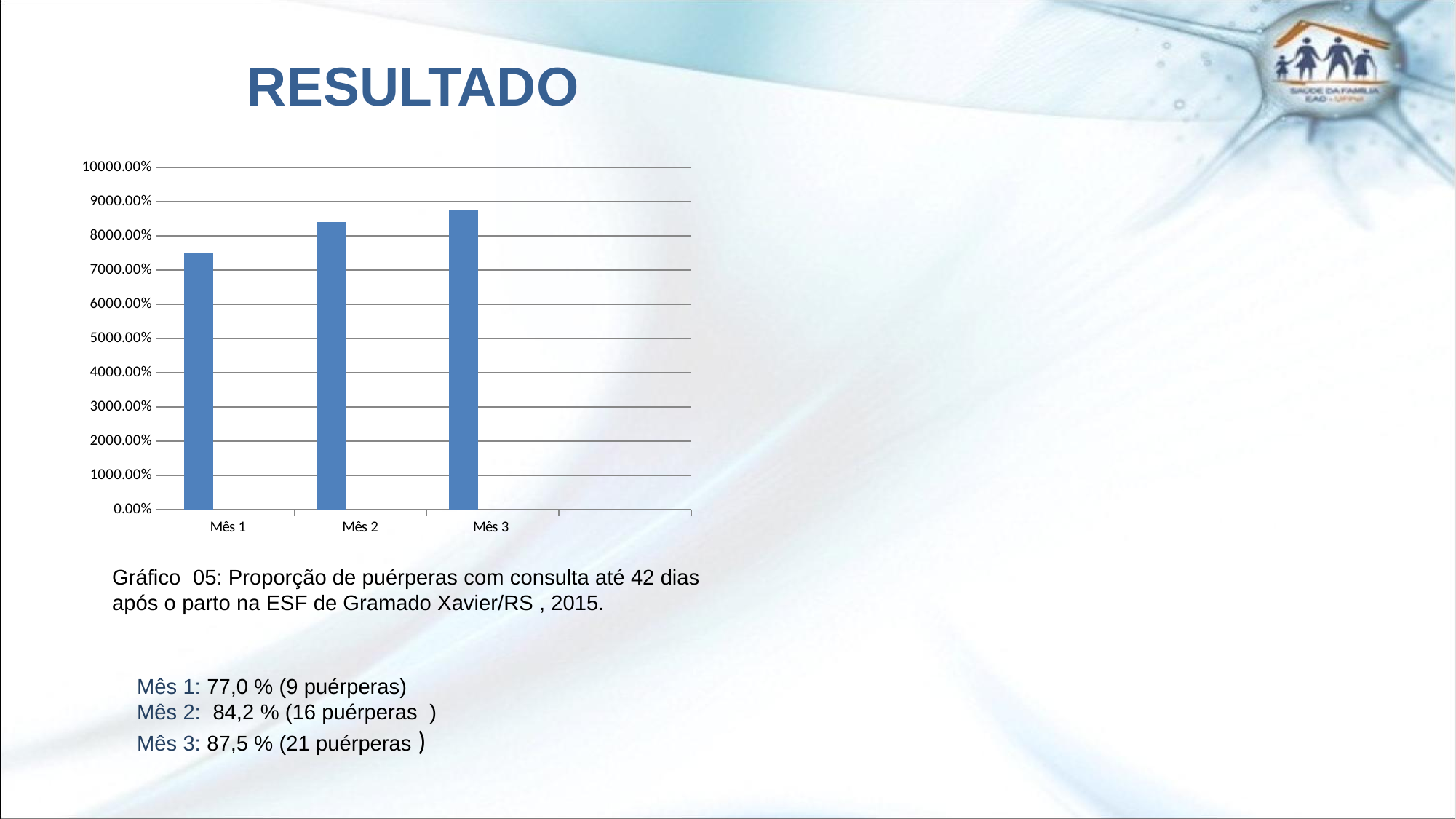
Is the bar for Mês 3 greater or less than 9000.00%? less Which month has the lowest bar in the chart? Mês 1 Which month has the highest bar in the chart? Mês 3 How many categories (months) are plotted in the chart? 3 Which is larger, the bar for Mês 2 or the bar for Mês 3? Mês 3 Do the bar values rise or fall from Mês 1 to Mês 3? rise What kind of chart is shown on the slide? bar chart Is the bar for Mês 2 greater or less than 8000.00%? greater Is the bar for Mês 1 greater or less than 7000.00%? greater What is the label of the first category on the horizontal axis? Mês 1 What is the highest value shown on the vertical axis of the chart? 10000.00%